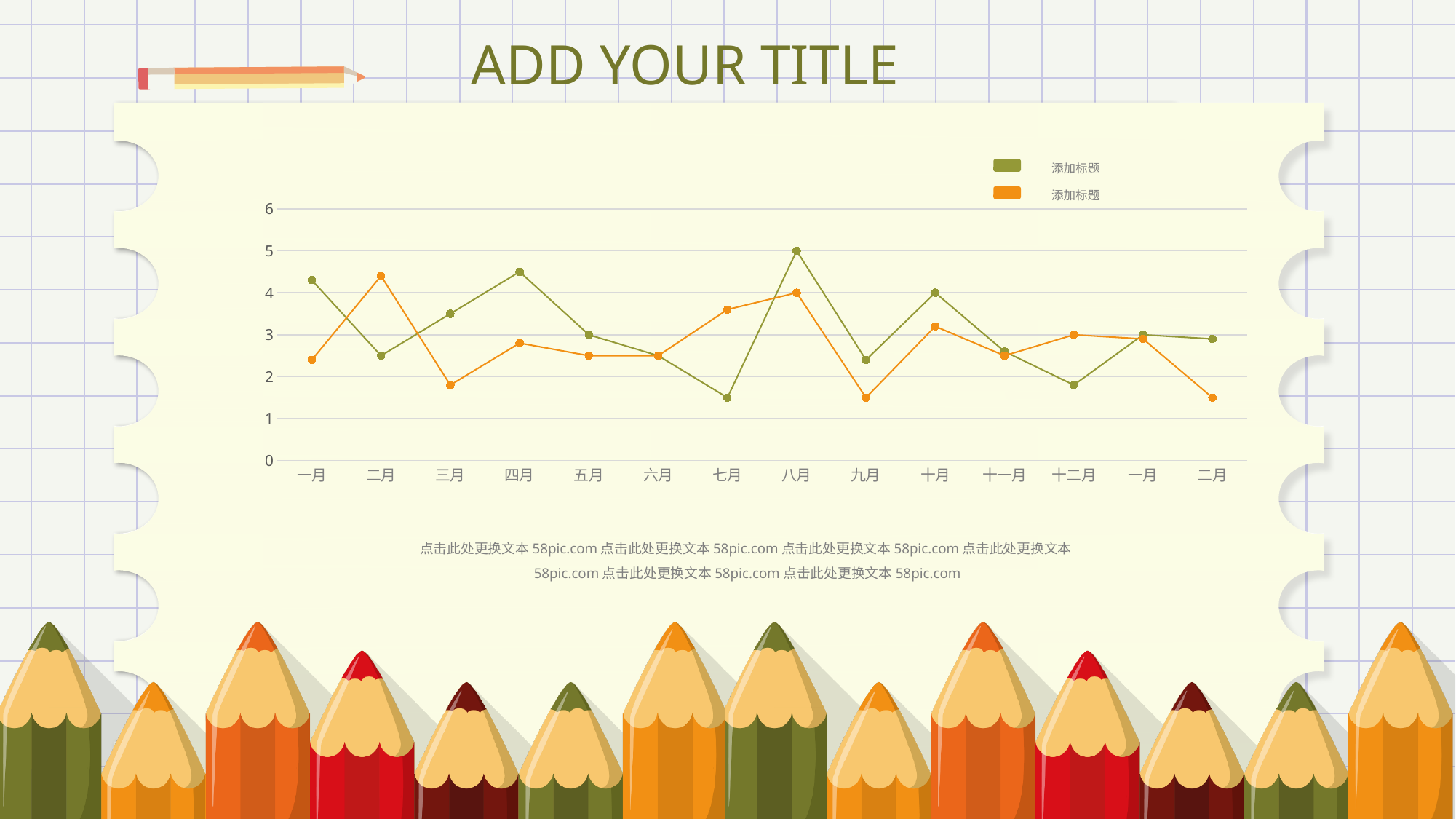
What kind of chart is shown on the slide? line chart What is the value of the green series in 八月? 5 What is the value of the green series in 十月? 4 How many series does the legend list? 2 How many categories are shown along the x axis? 14 In 三月, which series has the larger value, green or orange? green What is the value of the orange series in 八月? 4 Is the value of the green series in 七月 greater or less than 2? less Is the value of the orange series in 三月 greater or less than 2? less Does the green series rise or fall from 七月 to 八月? rise What is the difference between the green and orange series in 八月? 1 In which month does the green series reach its highest value? 八月